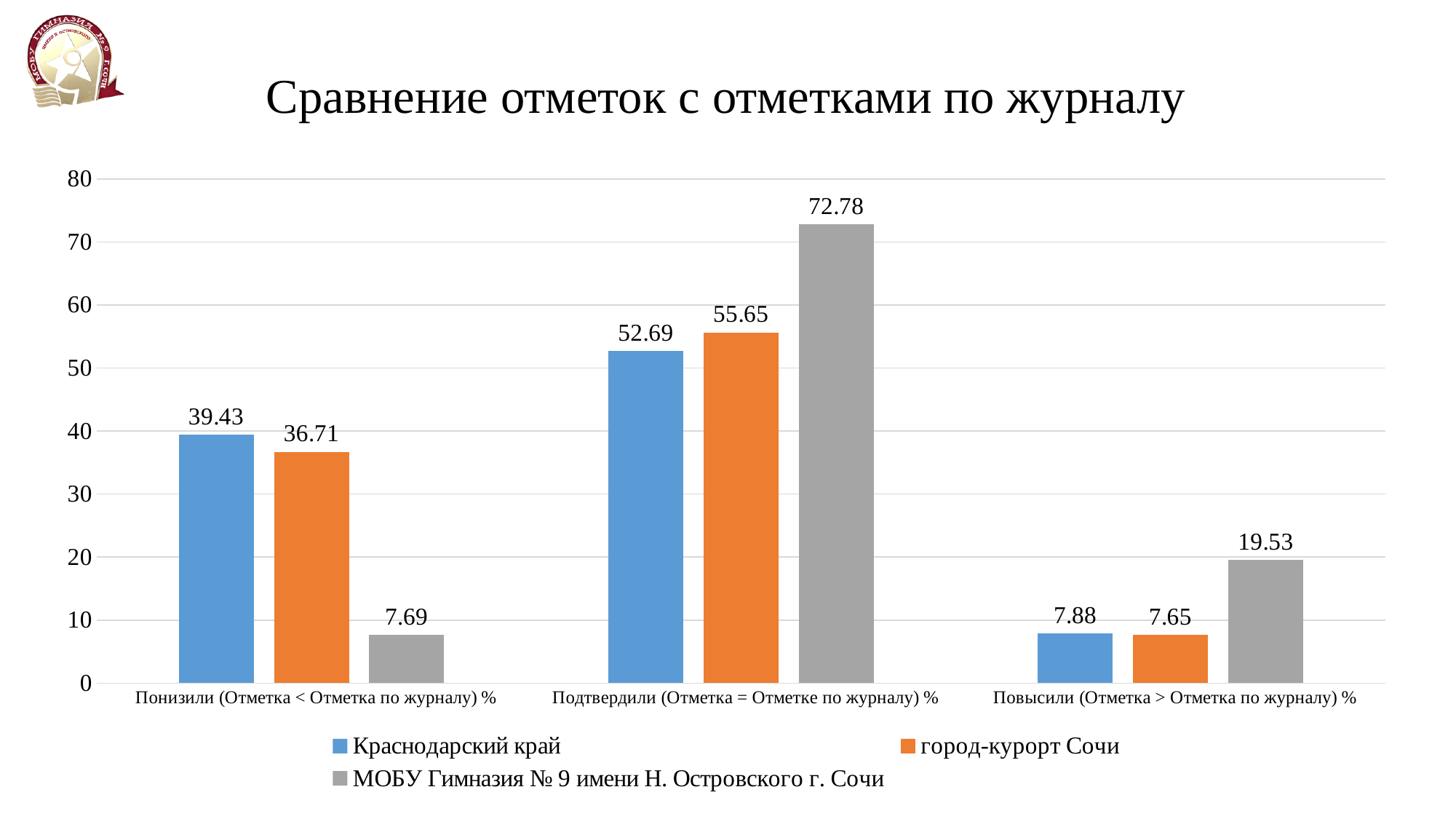
How many categories are shown on the x axis of the chart? 3 What is the value for город-курорт Сочи in the Повысили (Отметка > Отметка по журналу) % category? 7.65 What is the value for Краснодарский край in the Подтвердили (Отметка = Отметке по журналу) % category? 52.69 In the Повысили (Отметка > Отметка по журналу) % category, which is larger: the value for Краснодарский край or for МОБУ Гимназия № 9 имени Н. Островского г. Сочи? МОБУ Гимназия № 9 имени Н. Островского г. Сочи What is the value for МОБУ Гимназия № 9 имени Н. Островского г. Сочи in the Понизили (Отметка < Отметка по журналу) % category? 7.69 Is the value for МОБУ Гимназия № 9 in the Подтвердили (Отметка = Отметке по журналу) % category greater or less than 70? greater What kind of chart is shown on the slide? bar chart What is the difference between the Краснодарский край value and the МОБУ Гимназия № 9 value in the Понизили (Отметка < Отметка по журналу) % category? 31.74 Which series has the lowest value in the Понизили (Отметка < Отметка по журналу) % category? МОБУ Гимназия № 9 имени Н. Островского г. Сочи Which series has the highest value in the Подтвердили (Отметка = Отметке по журналу) % category? МОБУ Гимназия № 9 имени Н. Островского г. Сочи What is the difference between the МОБУ Гимназия № 9 value and the город-курорт Сочи value in the Подтвердили (Отметка = Отметке по журналу) % category? 17.13 How many series does the legend list? 3